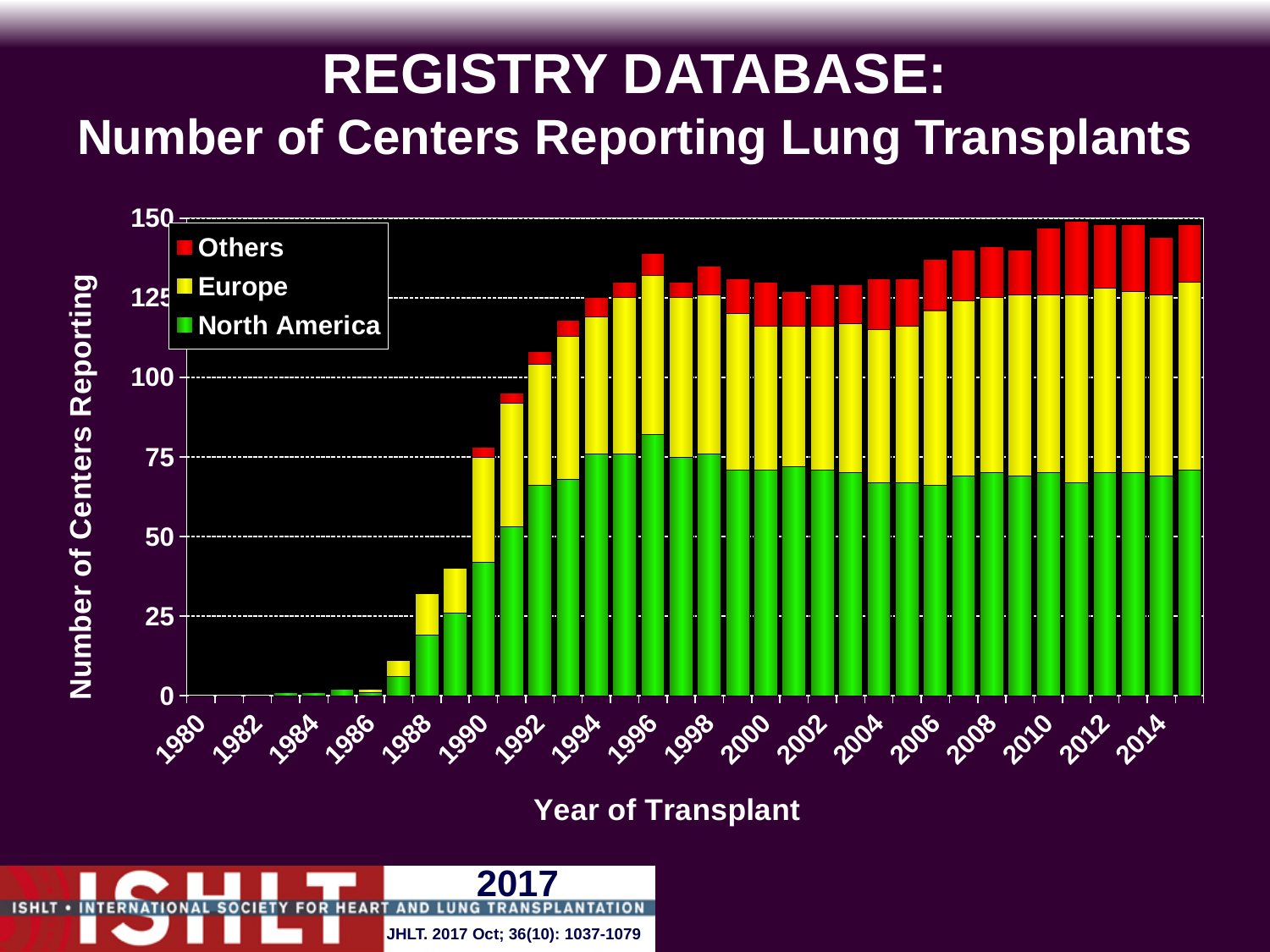
What kind of chart is shown on the slide? Stacked bar chart Is the total number of centers reporting in 1988 greater or less than 50? less Which series is shown in yellow in the legend? Europe Is the total number of centers reporting in 1986 greater or less than 25? less Is the total number of centers reporting in 1996 greater or less than 125? greater What is the label of the y axis? Number of Centers Reporting Which year has the larger total number of centers reporting, 1990 or 1996? 1996 How many series does the legend list? 3 Do the total numbers of centers reporting rise or fall from 1986 to 1996? rise